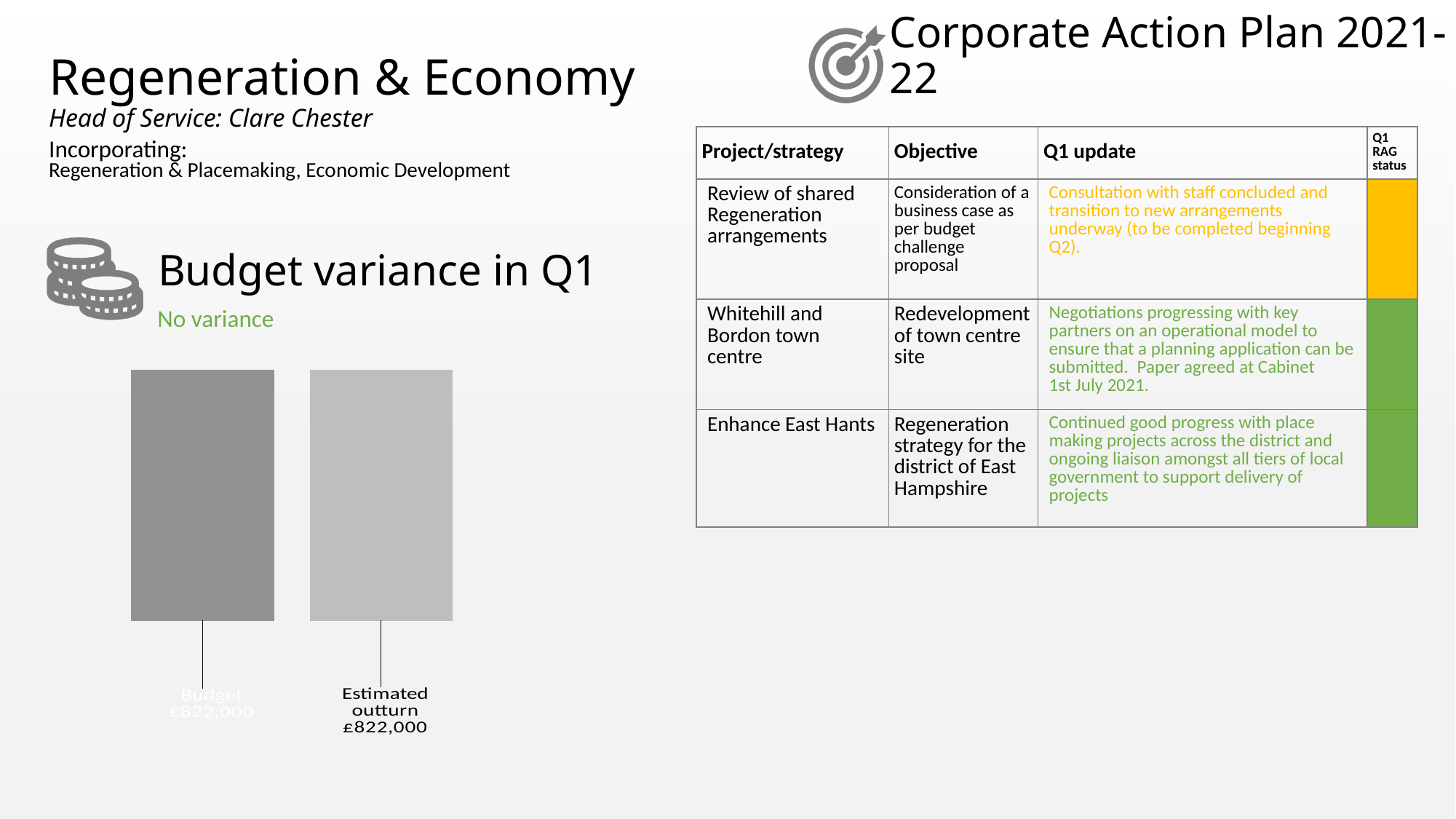
What is the value of the Budget bar in the budget variance chart? £822,000 How many bars does the budget variance chart show? 2 What is the difference between the Budget and the Estimated outturn in the budget variance chart? £0 What is the title of the chart on the left of the slide? Budget variance in Q1 What is the value of the Estimated outturn bar in the budget variance chart? £822,000 What kind of chart is shown under the heading "Budget variance in Q1"? bar chart What are the two categories shown in the budget variance chart? Budget and Estimated outturn